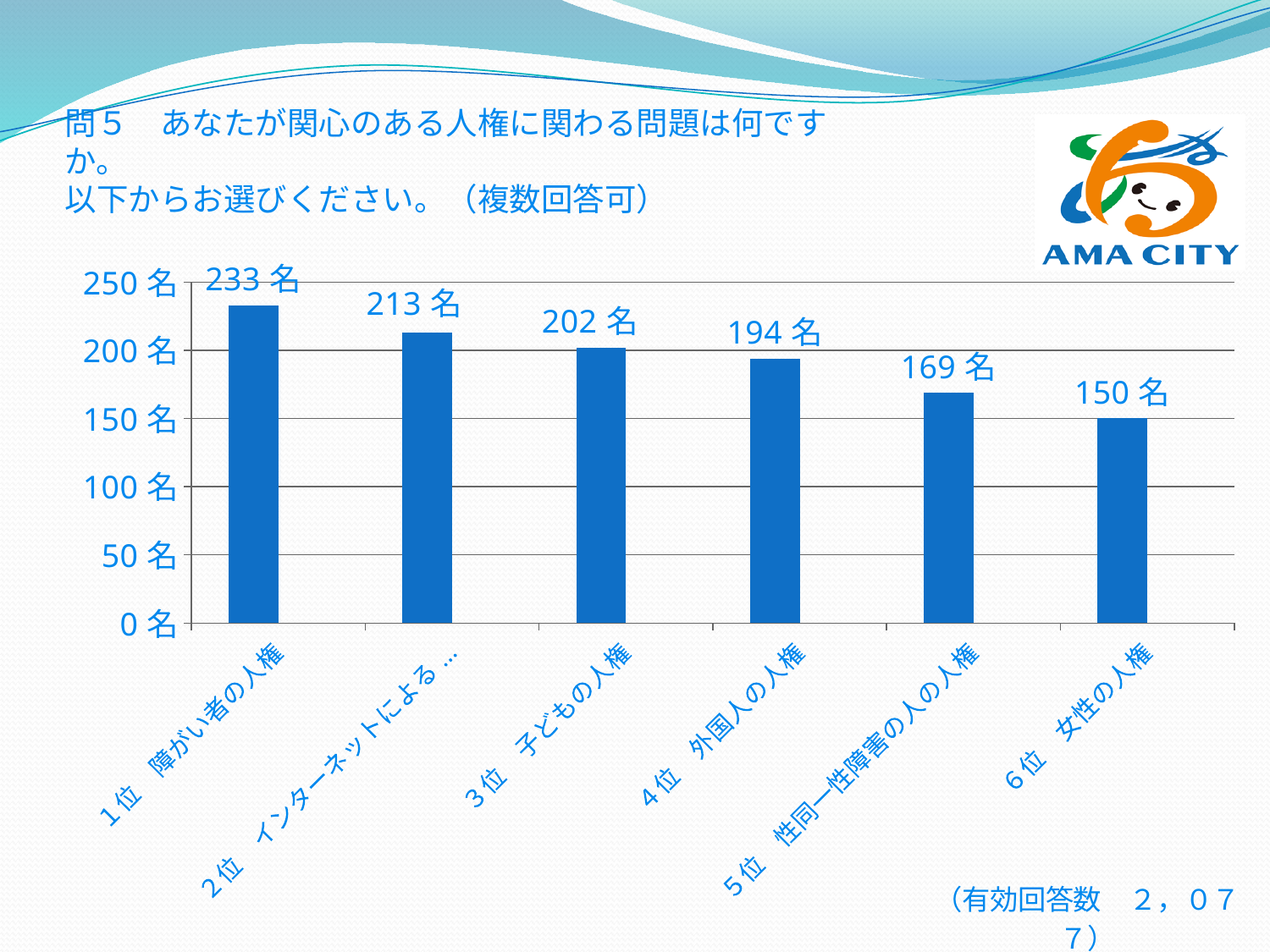
Which category has the highest value? 1位 障がい者の人権 Is the value for 4位 外国人の人権 greater or less than 200 名? less What is the difference between the values for 1位 障がい者の人権 and 6位 女性の人権? 83 名 Which category has the lowest value? 6位 女性の人権 What is the value for 6位 女性の人権? 150 名 What is the value for 3位 子どもの人権? 202 名 How many categories are shown in the chart? 6 What is the value for 1位 障がい者の人権? 233 名 What kind of chart is shown on the slide? bar chart Which is larger, the value for 4位 外国人の人権 or 5位 性同一性障害の人の人権? 4位 外国人の人権 What is the value for 5位 性同一性障害の人の人権? 169 名 What is the difference between the values for 3位 子どもの人権 and 4位 外国人の人権? 8 名